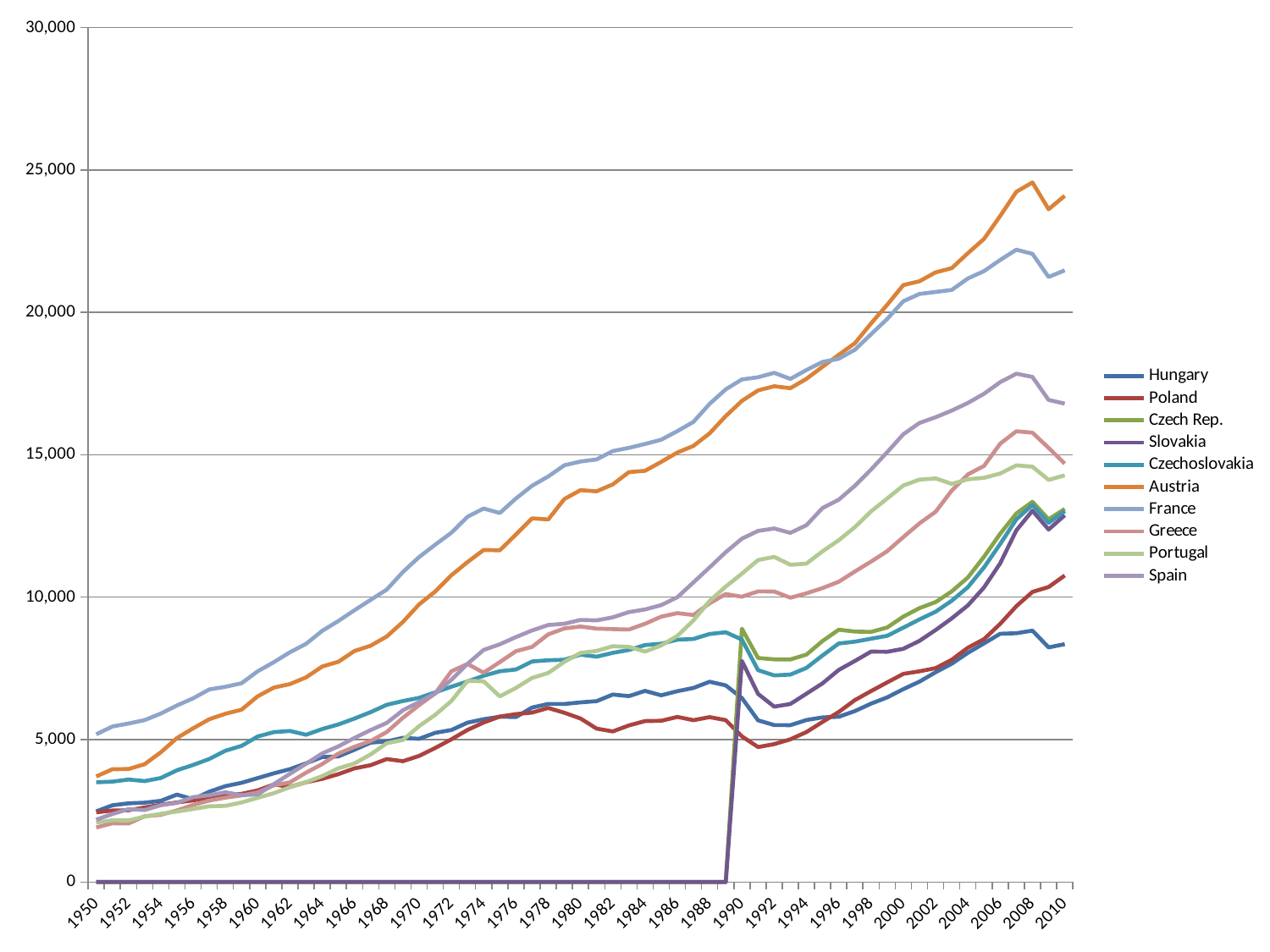
What kind of chart is shown on the slide? line chart Which series has the highest value in 2010? Austria Does the value for Austria generally rise or fall from 1950 to 2010? rise How many series does the legend list? 10 Which series has the highest value in 1950? France What is the maximum value shown on the vertical axis? 30,000 In 2010, which is larger, the value for Austria or the value for France? Austria In 2010, which is larger, the value for Poland or the value for Hungary? Poland Is the value for Hungary in 2010 greater or less than 10,000? less Is the value for Spain in 2010 greater or less than 15,000? greater Is the value for France in 1950 greater or less than 10,000? less